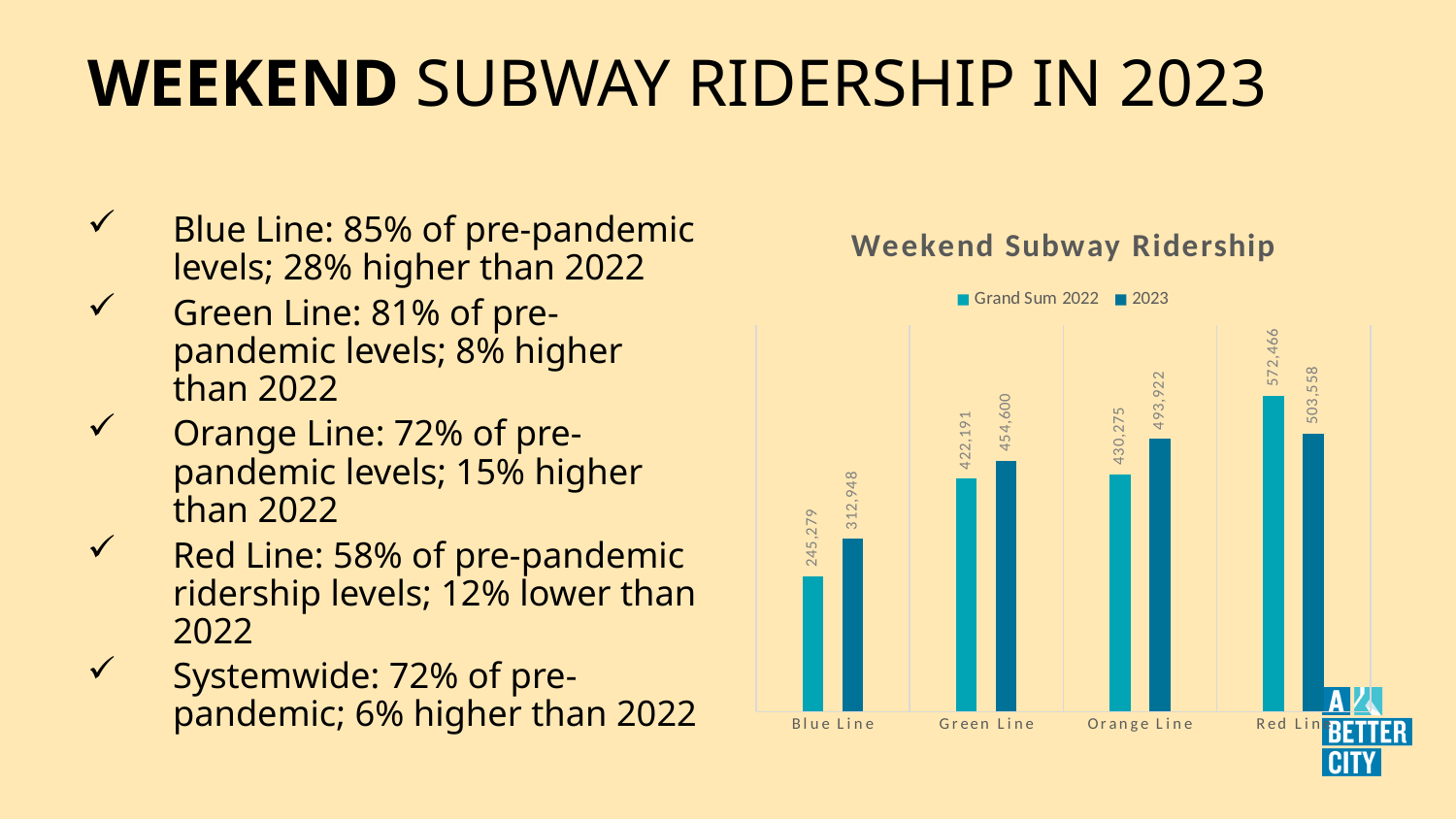
Which line has the highest Grand Sum 2022 value? Red Line For the Red Line, which is larger: the Grand Sum 2022 value or the 2023 value? Grand Sum 2022 What is the Grand Sum 2022 value for the Orange Line? 430,275 How many series does the legend list? 2 What is the 2023 value for the Green Line? 454,600 What is the 2023 weekend ridership value for the Blue Line? 312,948 What is the difference between the 2023 and Grand Sum 2022 values for the Blue Line? 67,669 What kind of chart is shown on the slide? Bar chart What is the difference between the Grand Sum 2022 and 2023 values for the Red Line? 68,908 What is the title of the chart? Weekend Subway Ridership How many lines (categories) are shown on the x axis? 4 Which line has the lowest 2023 value? Blue Line